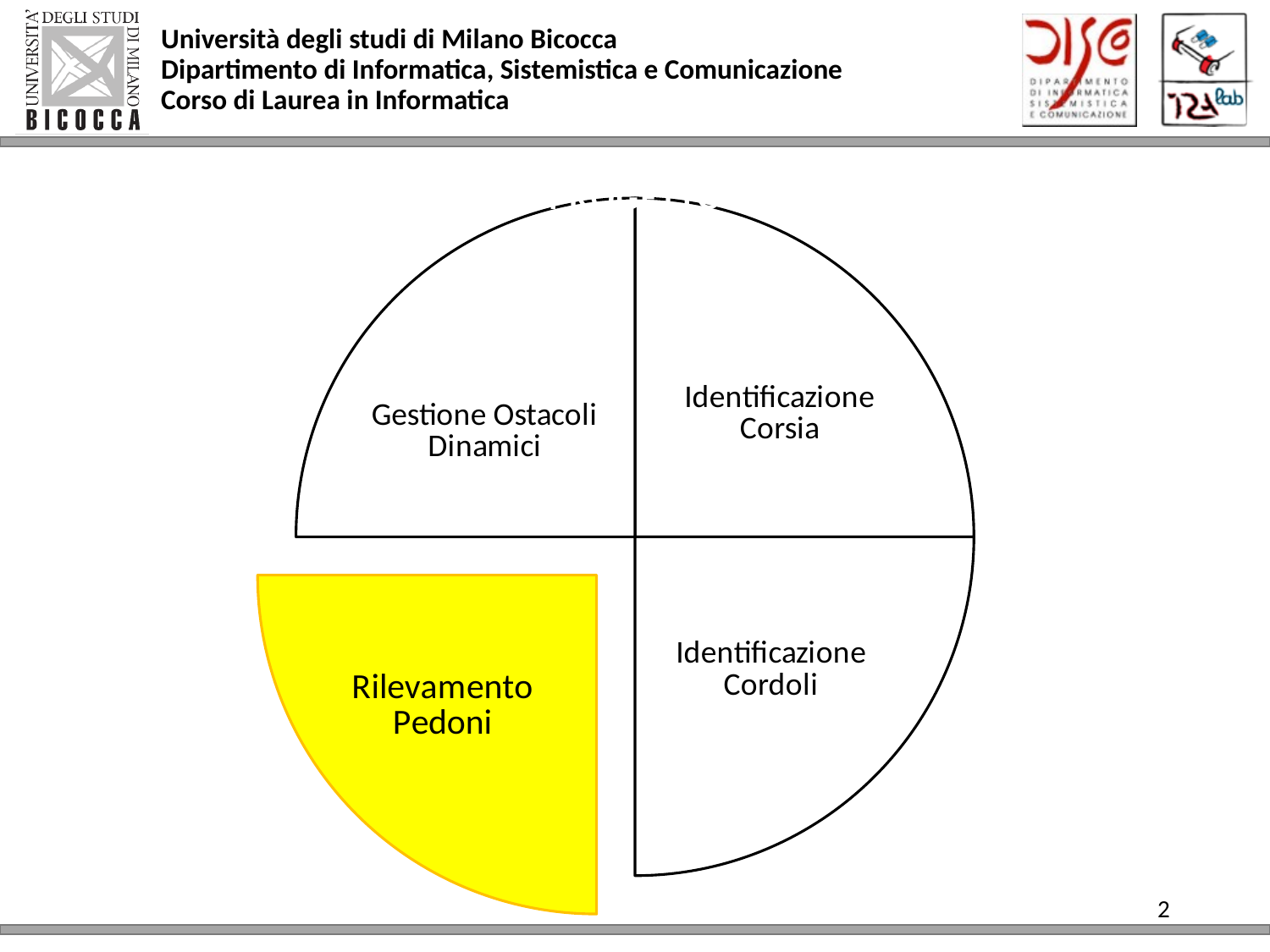
What is the label of the slice in the top-left quarter of the pie chart? Gestione Ostacoli Dinamici Which slice of the pie chart is pulled out (exploded) from the rest of the pie? Rilevamento Pedoni How many slices does the pie chart have? 4 What is the label of the slice in the top-right quarter of the pie chart? Identificazione Corsia What kind of chart is shown on the slide? pie chart What is the label of the slice in the bottom-right quarter of the pie chart? Identificazione Cordoli Which slice of the pie chart is filled in yellow? Rilevamento Pedoni